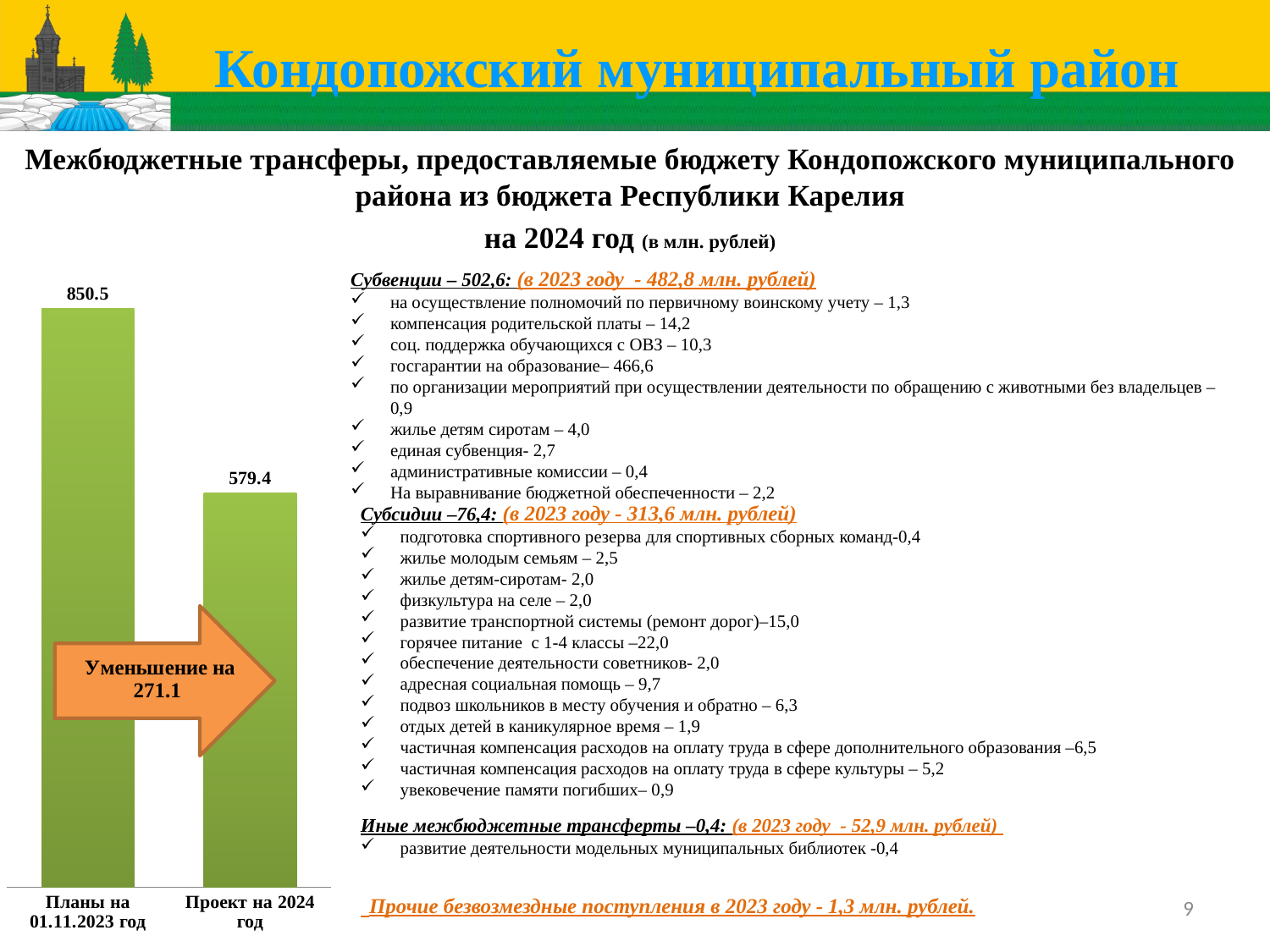
What is the difference between the values for "Планы на 01.11.2023 год" and "Проект на 2024 год"? 271.1 Which category has the highest value in the bar chart? Планы на 01.11.2023 год What decrease does the arrow on the chart indicate? Уменьшение на 271.1 How many bars are shown in the chart? 2 What is the value for "Проект на 2024 год" in the bar chart? 579.4 Which is larger: the value for "Планы на 01.11.2023 год" or the value for "Проект на 2024 год"? Планы на 01.11.2023 год In what units are the values in the chart given, according to the slide heading? млн. рублей Which category has the lowest value in the bar chart? Проект на 2024 год Do the values rise or fall from "Планы на 01.11.2023 год" to "Проект на 2024 год"? fall What kind of chart is shown on the slide? bar chart What is the value for "Планы на 01.11.2023 год" in the bar chart? 850.5